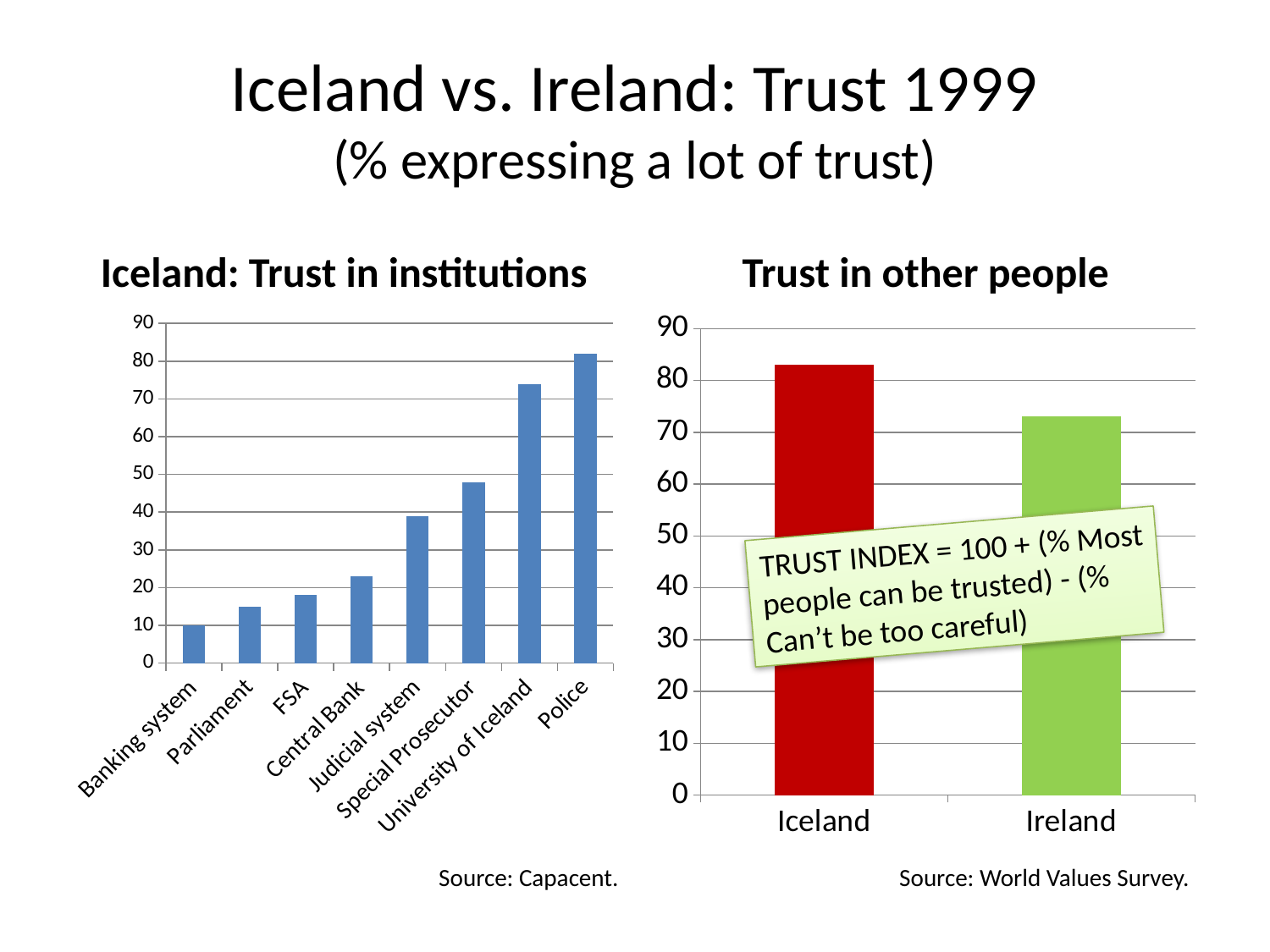
In the 'Iceland: Trust in institutions' chart, which institution has the highest value? Police In the 'Iceland: Trust in institutions' chart, which is larger, the value for Special Prosecutor or the value for University of Iceland? University of Iceland In the 'Iceland: Trust in institutions' chart, is the value for Police greater or less than 80? greater In the 'Iceland: Trust in institutions' chart, how many institutions are shown? 8 In the 'Iceland: Trust in institutions' chart, do the values rise or fall from left to right along the x axis? rise What kind of chart is the 'Trust in other people' chart? bar chart In the 'Iceland: Trust in institutions' chart, which institution has the lowest value? Banking system In the 'Trust in other people' chart, what colour is the bar for Ireland? green In the 'Trust in other people' chart, is the value for Ireland greater or less than 80? less In the 'Trust in other people' chart, which country has the higher value? Iceland In the 'Iceland: Trust in institutions' chart, is the value for Central Bank greater or less than 30? less